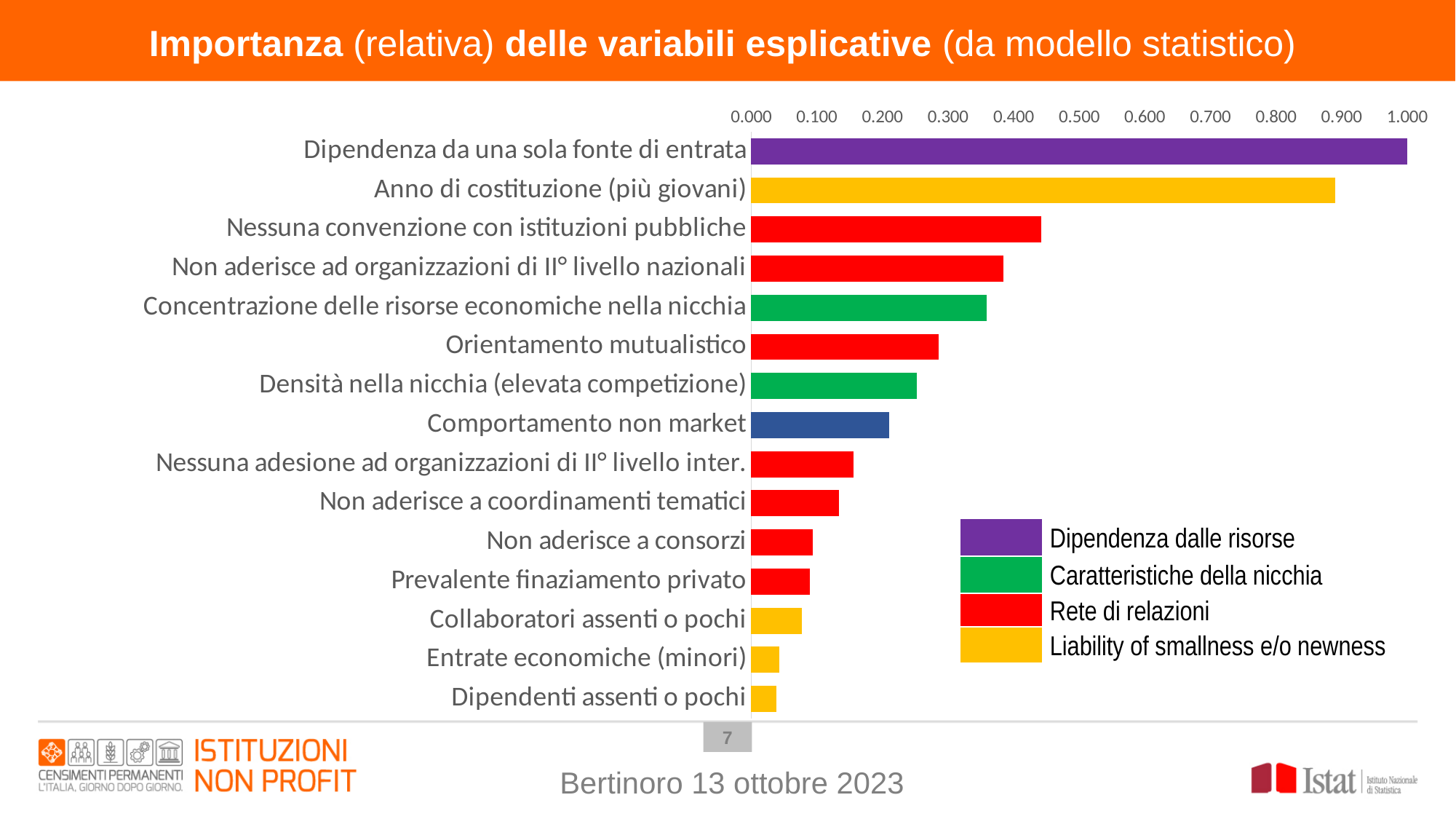
Which has a larger value: 'Nessuna convenzione con istituzioni pubbliche' or 'Concentrazione delle risorse economiche nella nicchia'? Nessuna convenzione con istituzioni pubbliche Which legend category is shown in red in the chart? Rete di relazioni Is the value for 'Nessuna convenzione con istituzioni pubbliche' greater or less than 0.400? greater Is the value for 'Anno di costituzione (più giovani)' greater or less than 0.800? greater How many entries does the chart legend list? 4 Which has a larger value: 'Comportamento non market' or 'Densità nella nicchia (elevata competizione)'? Densità nella nicchia (elevata competizione) How many categories (variables) are plotted in the chart? 15 Is the value for 'Orientamento mutualistico' greater or less than 0.300? less What kind of chart is shown on the slide? bar chart Which variable has the highest relative importance in the chart? Dipendenza da una sola fonte di entrata Which legend category does the purple bar represent? Dipendenza dalle risorse